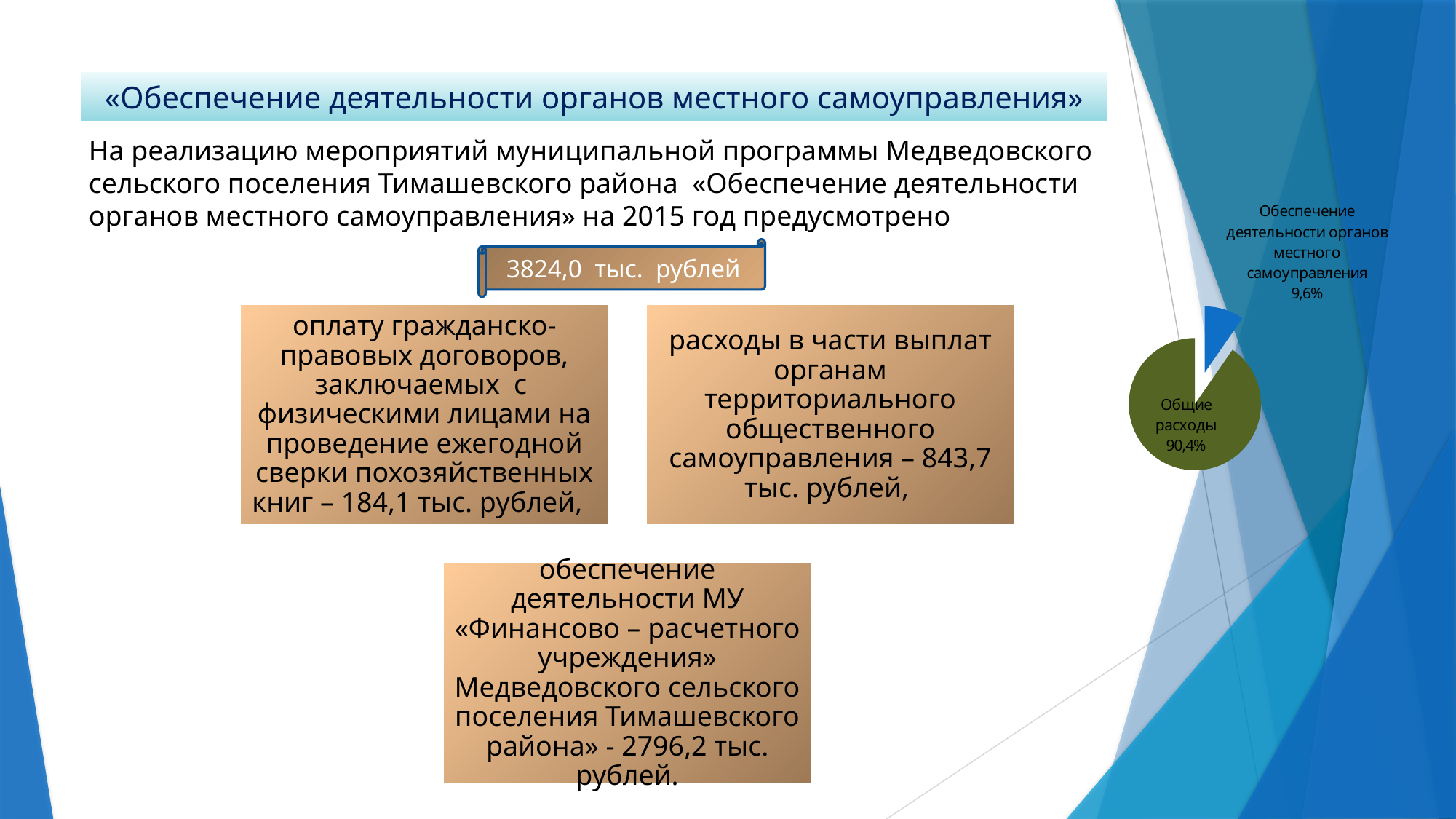
Is the share of "Общие расходы" in the pie chart greater or less than 50%? greater What share of the pie chart is labelled "Общие расходы"? 90,4% How many slices does the pie chart have? 2 What share of the pie chart is labelled "Обеспечение деятельности органов местного самоуправления"? 9,6% In the pie chart, which is larger: "Общие расходы" or "Обеспечение деятельности органов местного самоуправления"? Общие расходы What colour is the "Общие расходы" slice in the pie chart? dark green Is the share of "Обеспечение деятельности органов местного самоуправления" in the pie chart greater or less than 10%? less What is the difference in percentage points between the "Общие расходы" slice and the "Обеспечение деятельности органов местного самоуправления" slice in the pie chart? 80,8 What kind of chart is shown on the right side of the slide? pie chart Which slice of the pie chart is the largest? Общие расходы What colour is the "Обеспечение деятельности органов местного самоуправления" slice in the pie chart? blue Which slice of the pie chart is the smallest? Обеспечение деятельности органов местного самоуправления